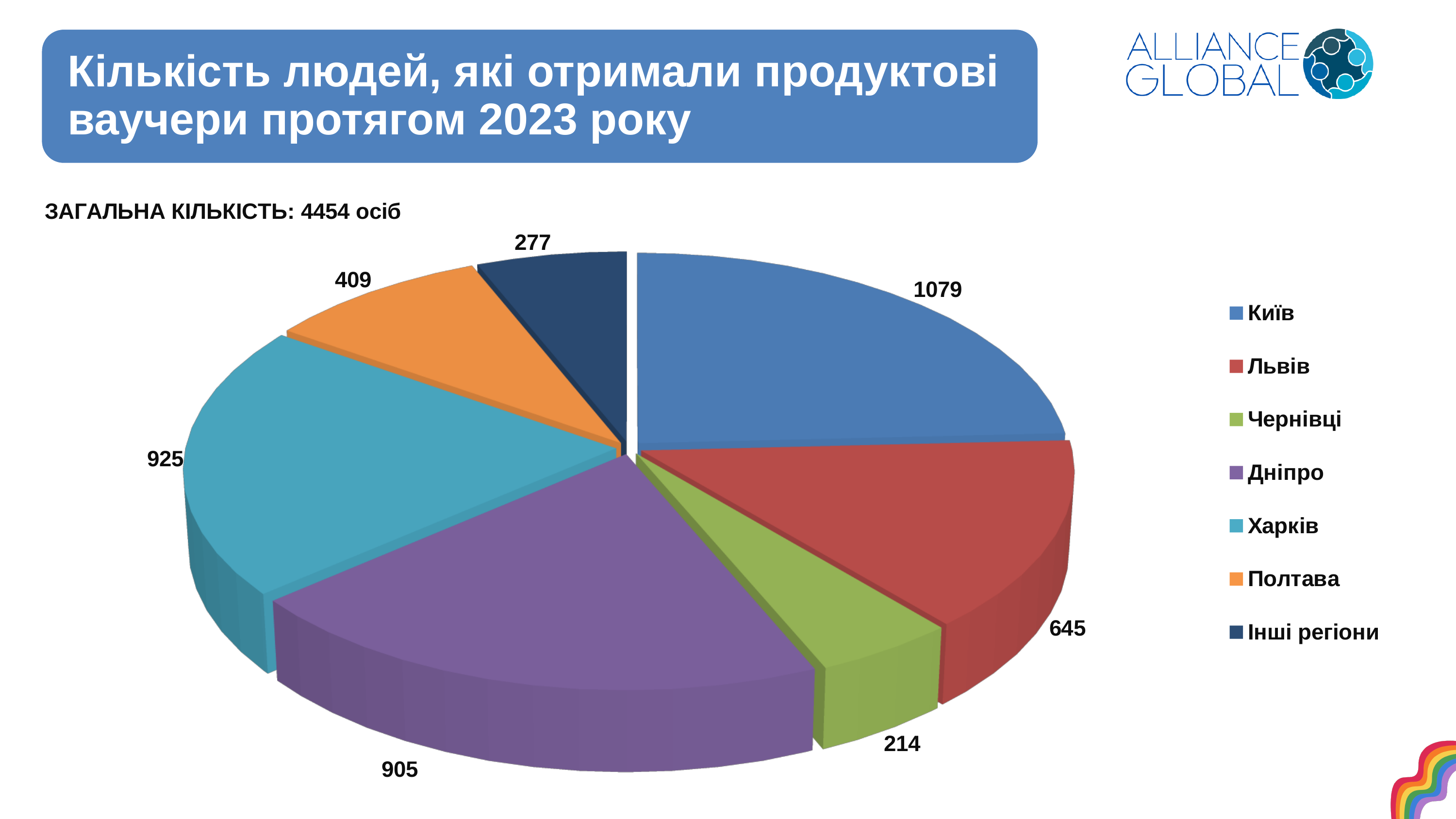
What is the total number of people shown on the slide? 4454 осіб Which has a larger value, Харків or Дніпро? Харків Which region has the smallest slice of the pie? Чернівці Which region has the largest slice of the pie? Київ How many categories does the pie chart have? 7 What is the value shown for Полтава? 409 How many people received product vouchers in Київ? 1079 What is the value shown for Чернівці? 214 Which legend entry is shown in dark navy blue? Інші регіони What type of chart is shown on the slide? Pie chart What is the value shown for Львів? 645 What is the difference between the values for Київ and Львів? 434